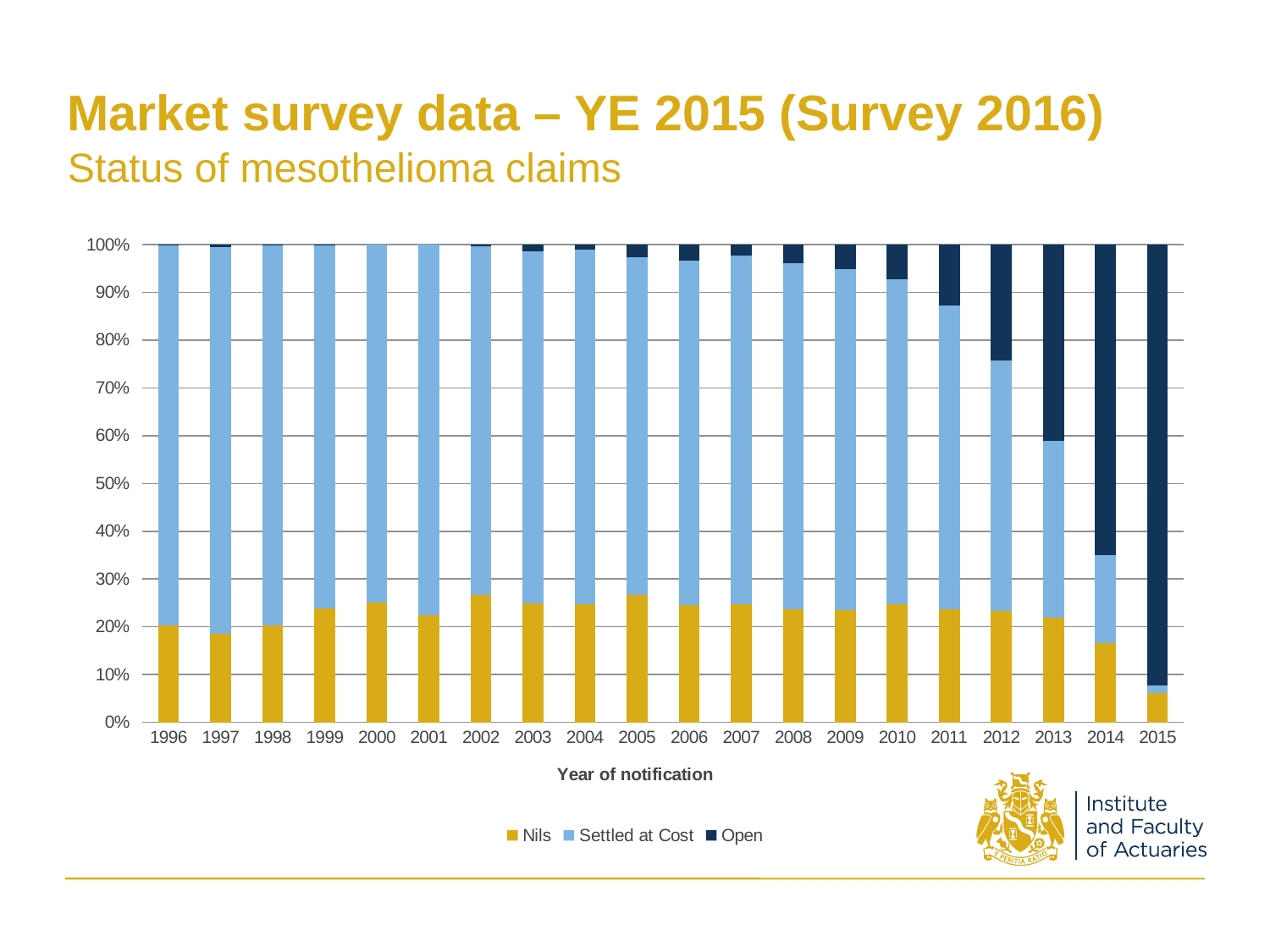
Is the Open share for 2014 greater or less than 60%? greater Is the Nils share for 2002 greater or less than 20%? greater Which year has the largest Open share? 2015 Which year has the smallest Settled at Cost share? 2015 How many years of notification are shown on the x axis? 20 Is the Nils share for 2014 greater or less than 20%? less Does the Open share generally rise or fall as the year of notification increases? rise Which is larger, the Open share in 2015 or the Open share in 2014? 2015 How many series does the legend list? 3 Which year has the smallest Nils share? 2015 What kind of chart is shown on the slide? Stacked bar chart What is the title of the x axis? Year of notification